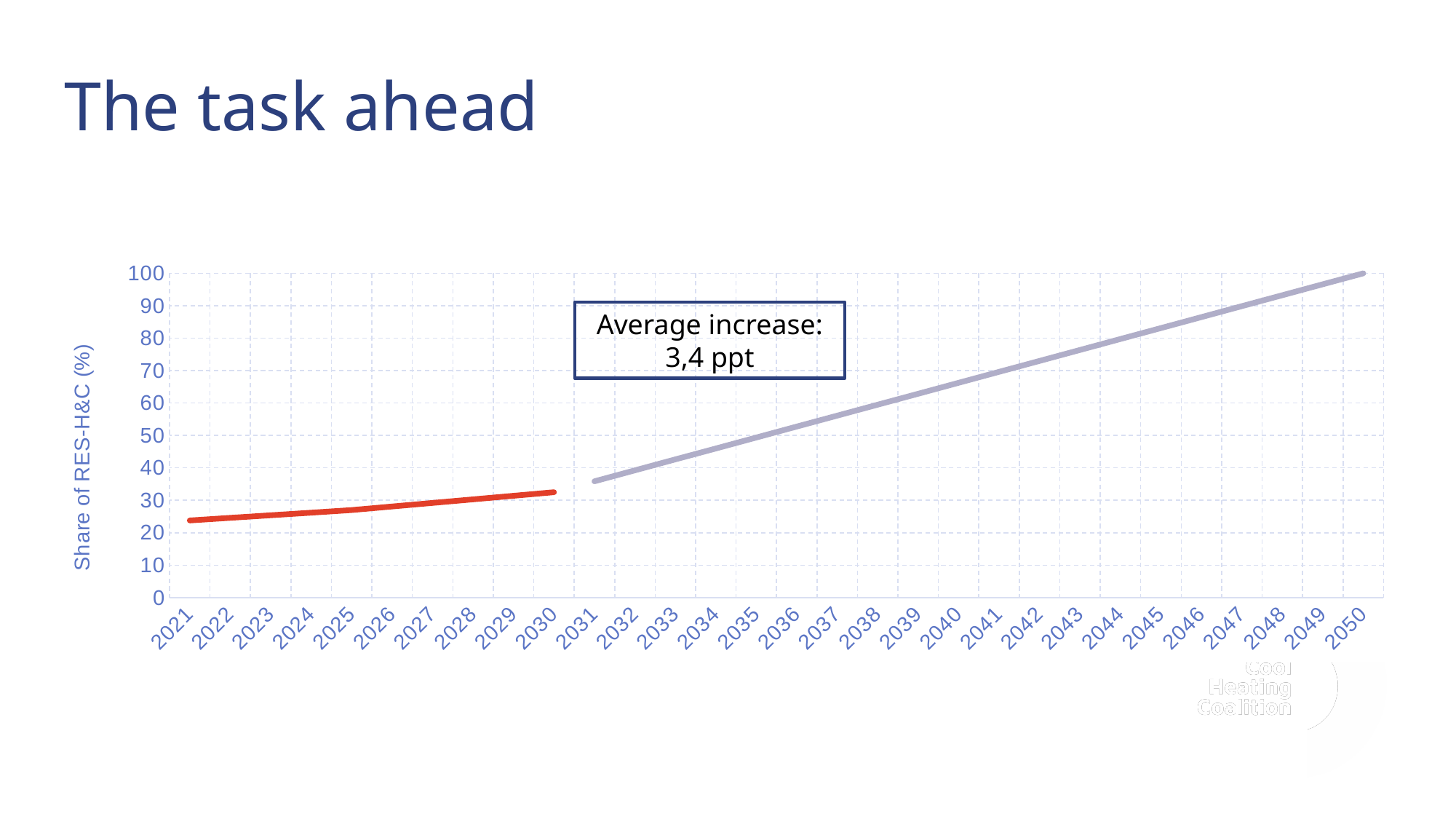
Is the value for 2040 greater or less than 60? greater What kind of chart is shown on the slide? line chart What is the title of the slide containing the chart? The task ahead Do the values rise or fall from 2021 to 2050? rise Is the value for 2021 greater or less than 30? less What value does the line reach in 2050? 100 Is the value for 2030 greater or less than 30? greater Which year has the highest value on the chart? 2050 What is the label of the vertical axis? Share of RES-H&C (%) How many years are labelled along the x axis? 30